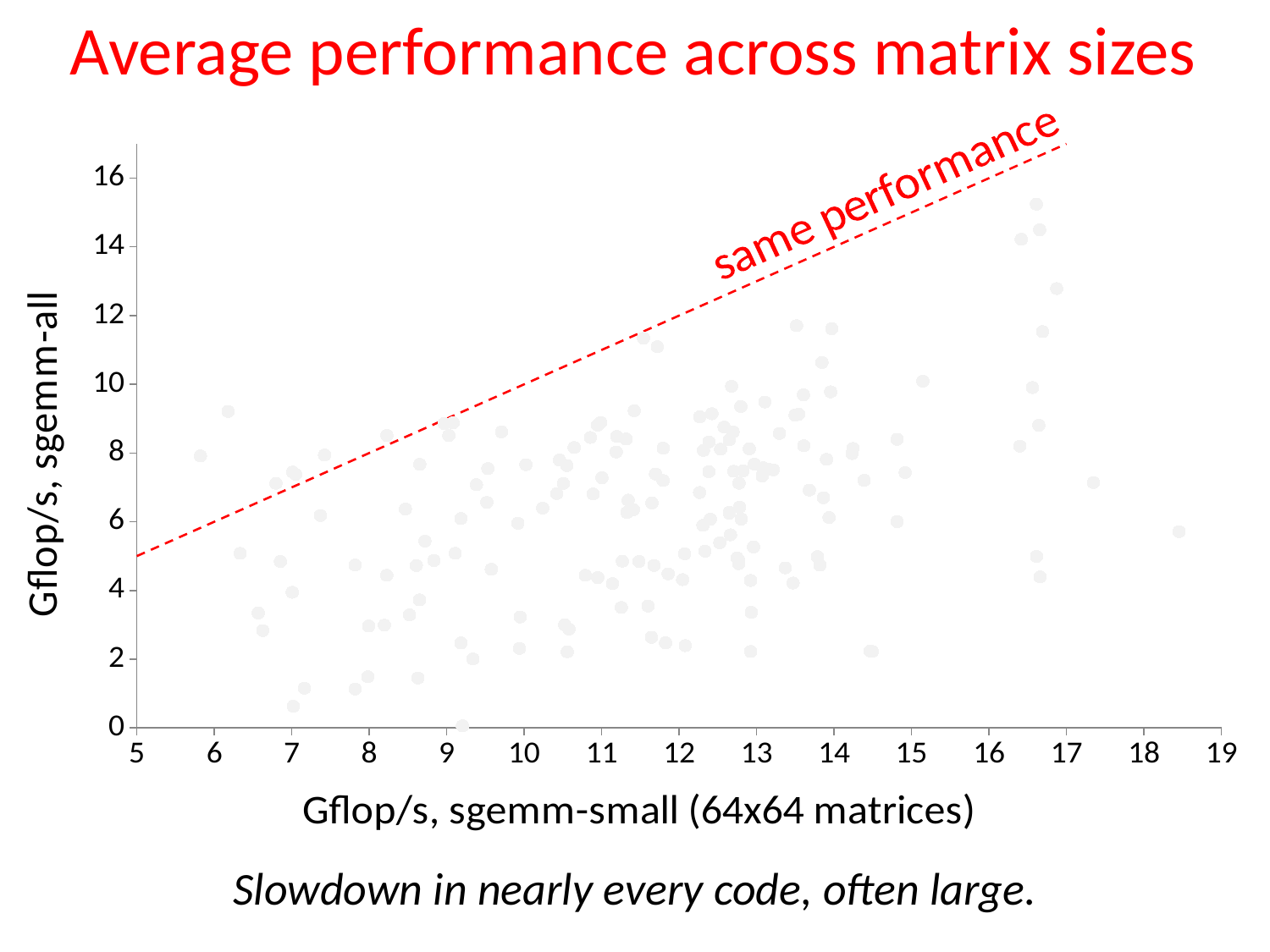
Does the dashed red line rise or fall as the x-axis value increases? rises What kind of chart is shown on the slide? scatter plot What is the title of the chart? Average performance across matrix sizes What label is written along the dashed red line? same performance